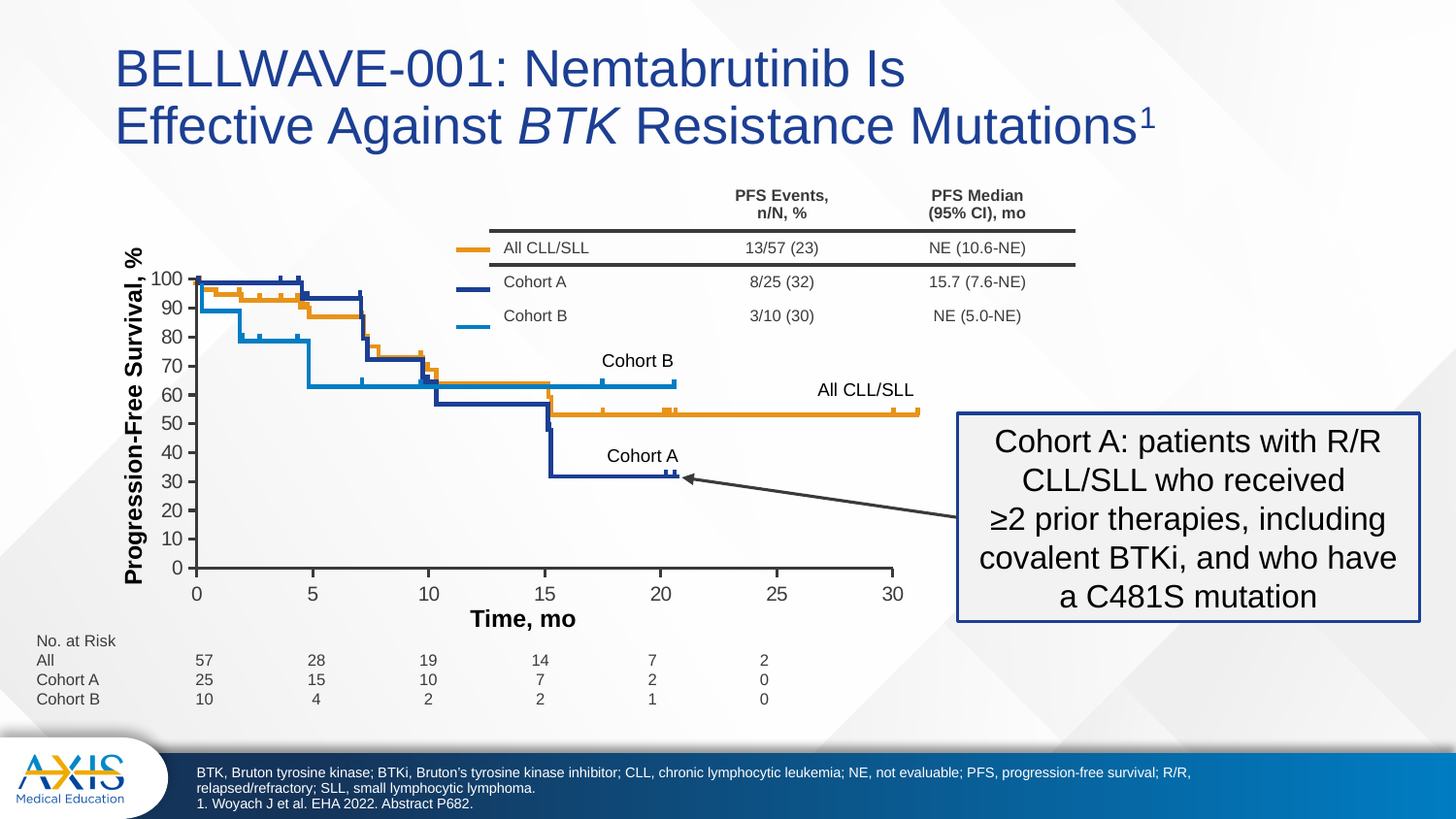
What is the label of the x-axis on the chart? Time, mo What kind of chart is shown on the slide? Line chart (Kaplan-Meier curve) According to the table, what are the PFS events (n/N, %) for All CLL/SLL? 13/57 (23) According to the table, what is the PFS median (95% CI) in months for Cohort A? 15.7 (7.6-NE) Is the progression-free survival for Cohort A at 20 months greater or less than 40%? less Which group has the lowest progression-free survival at 20 months? Cohort A How many patients in the All group were at risk at 0 months? 57 How many patients in Cohort A were at risk at 10 months? 10 What is the label of the y-axis on the chart? Progression-Free Survival, % Is the progression-free survival for Cohort B at 20 months greater or less than 60%? greater How many groups (series) are plotted on the progression-free survival chart? 3 According to the table, what are the PFS events (n/N, %) for Cohort B? 3/10 (30)